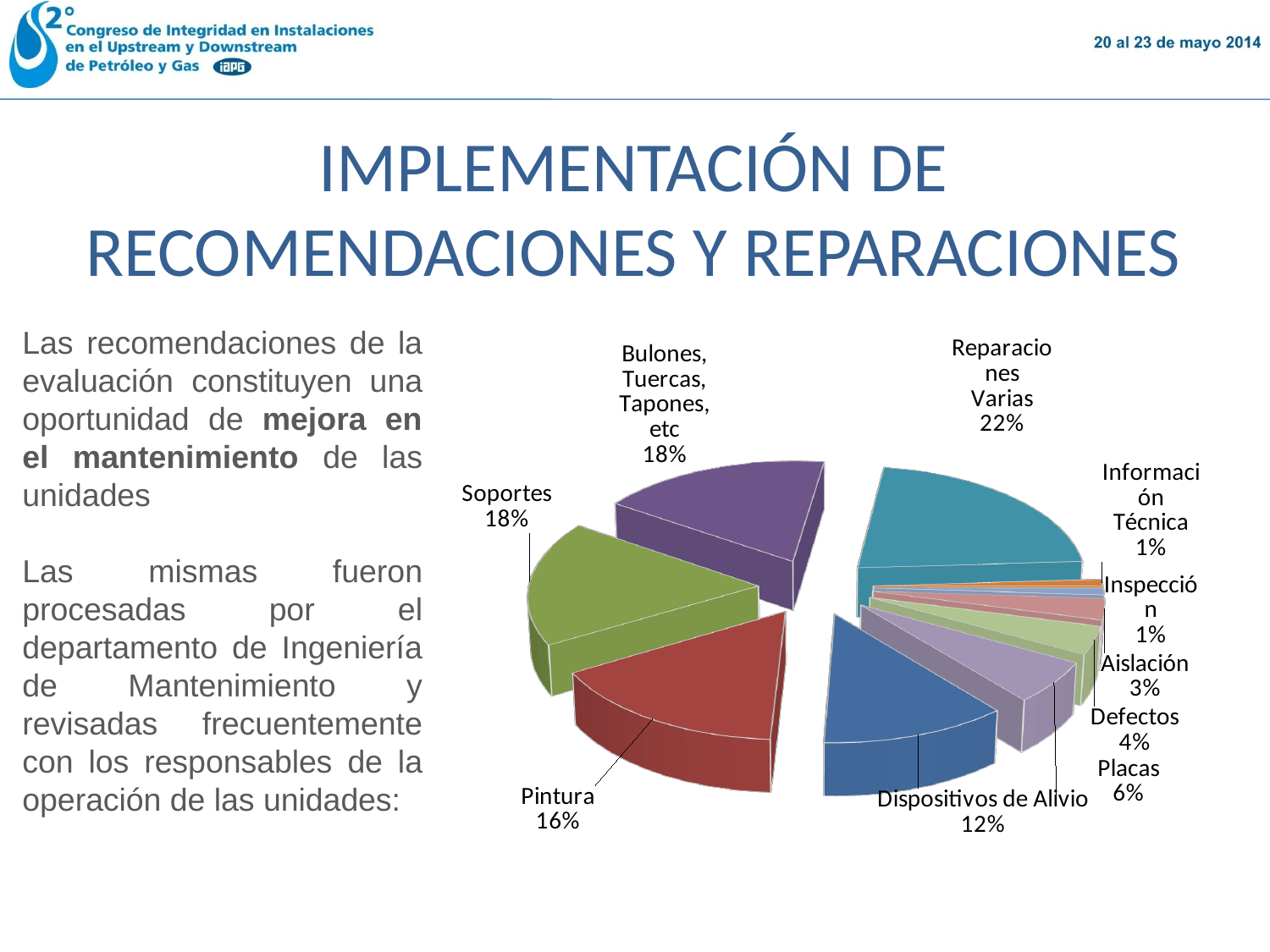
What type of chart is shown on the slide? pie chart How many slices does the pie chart have? 10 What is the difference in percentage points between Dispositivos de Alivio and Defectos? 8 What percentage is shown for Placas? 6% What percentage is shown for Dispositivos de Alivio? 12% Which category has the largest share of the pie? Reparaciones Varias What percentage is shown for Aislación? 3% What share of the pie does Soportes represent? 18% What share of the pie does Pintura represent? 16% What percentage is shown for Reparaciones Varias? 22% What is the difference in percentage points between Reparaciones Varias and Pintura? 6 Which is larger, the share for Defectos or the share for Placas? Placas